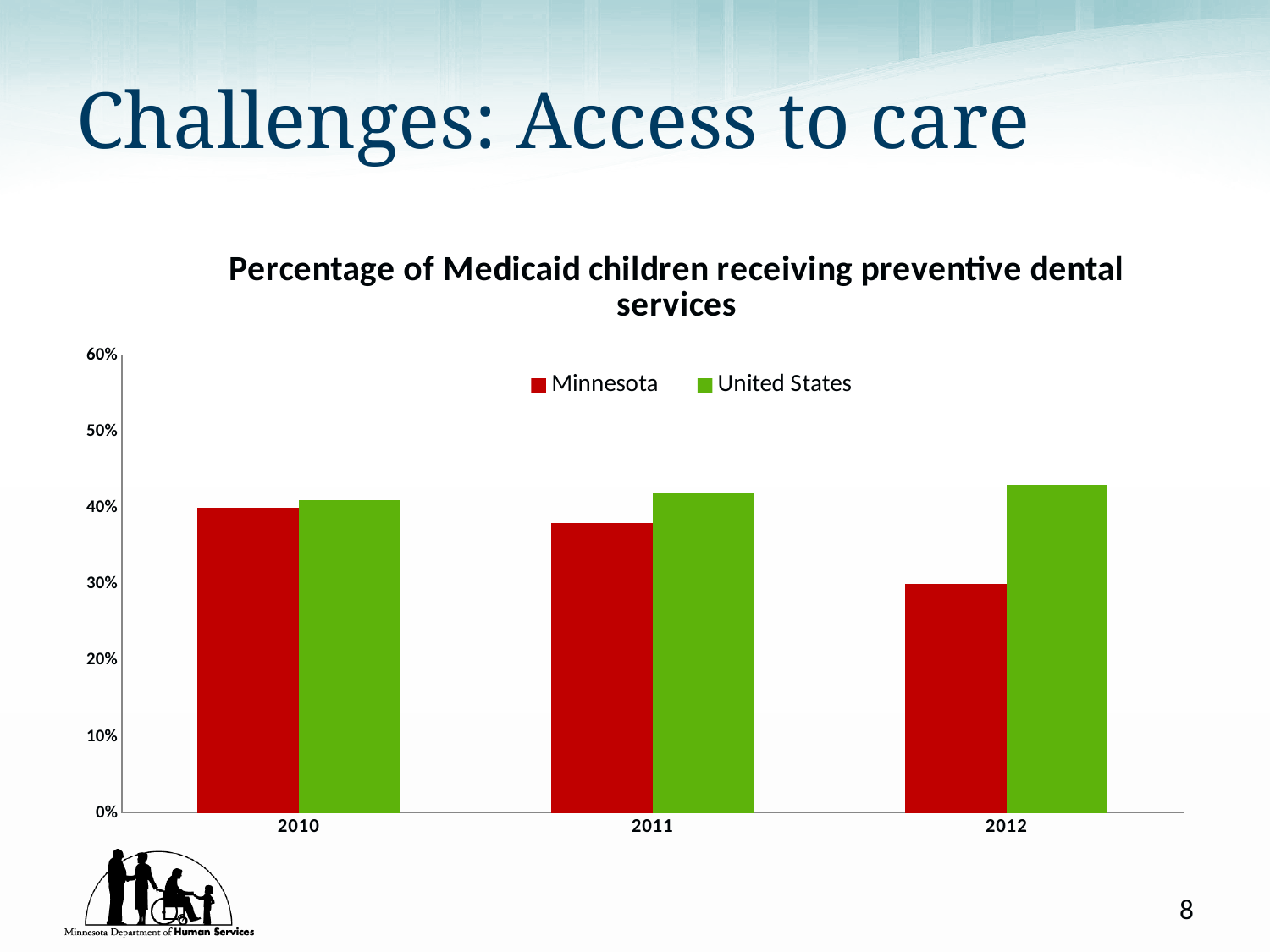
In 2011, which is larger: Minnesota or United States? United States Is the value for Minnesota in 2012 greater or less than 40%? less Is the value for Minnesota in 2011 greater or less than 30%? greater Which colour represents Minnesota in the chart? Red In 2012, which is larger: Minnesota or United States? United States How many years are shown on the x axis? 3 In which year is the Minnesota value lowest? 2012 What kind of chart is shown on the slide? Bar chart What is the title of the chart? Percentage of Medicaid children receiving preventive dental services Is the value for United States in 2012 greater or less than 40%? greater Do the Minnesota values rise or fall from 2010 to 2012? Fall How many series does the legend list? 2